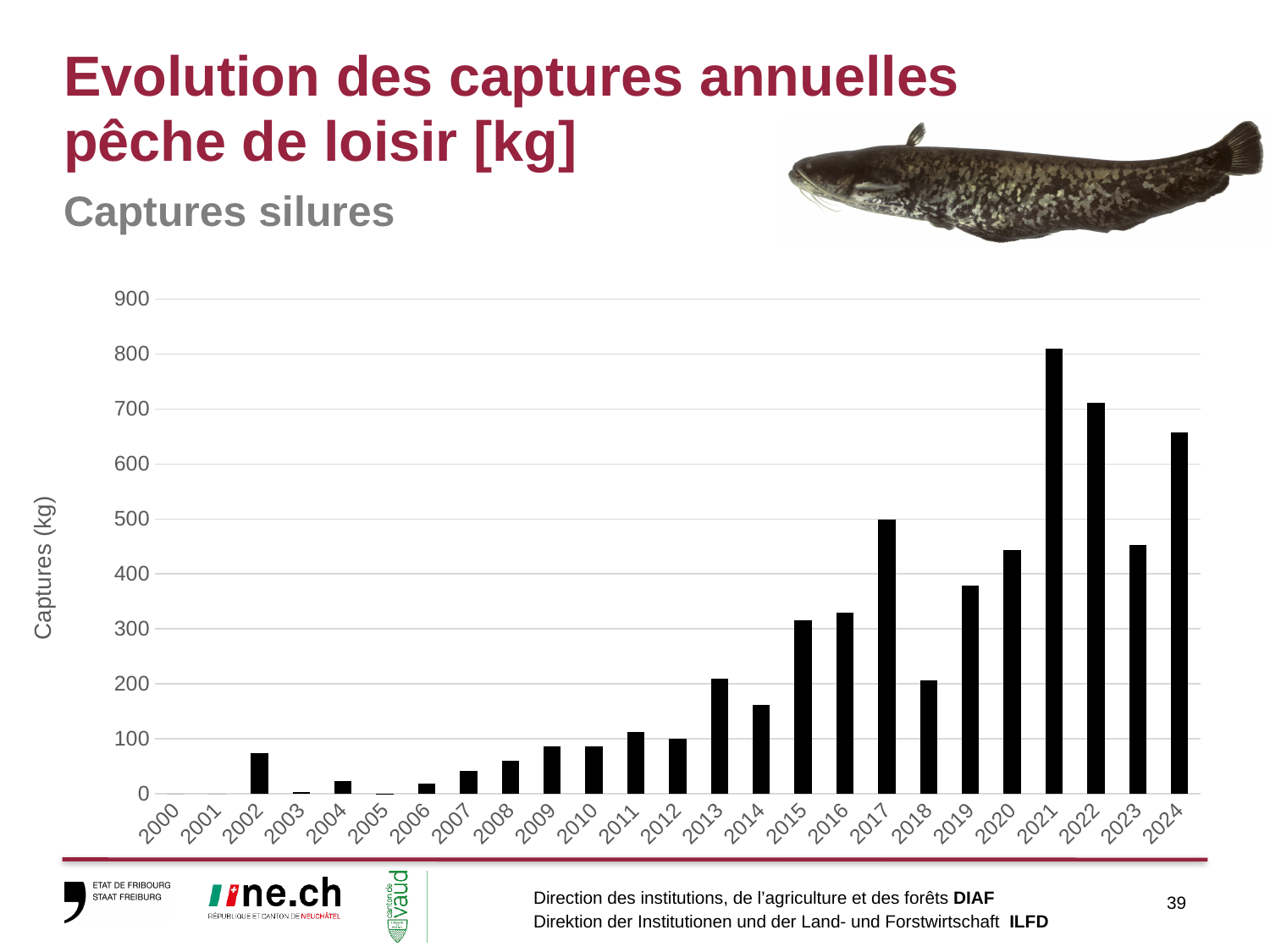
Is the value for 2018 greater or less than 300? less Which year has the larger value, 2021 or 2022? 2021 How many years are shown on the x axis of the chart? 25 What kind of chart is shown on the slide? bar chart Which year has the highest catch of silures? 2021 Is the value for 2013 greater or less than 300? less Is the value for 2024 greater or less than 600? greater What is the label of the vertical axis of the chart? Captures (kg) Which year has the larger value, 2017 or 2018? 2017 Overall, do the catches rise or fall from 2000 to 2024? rise